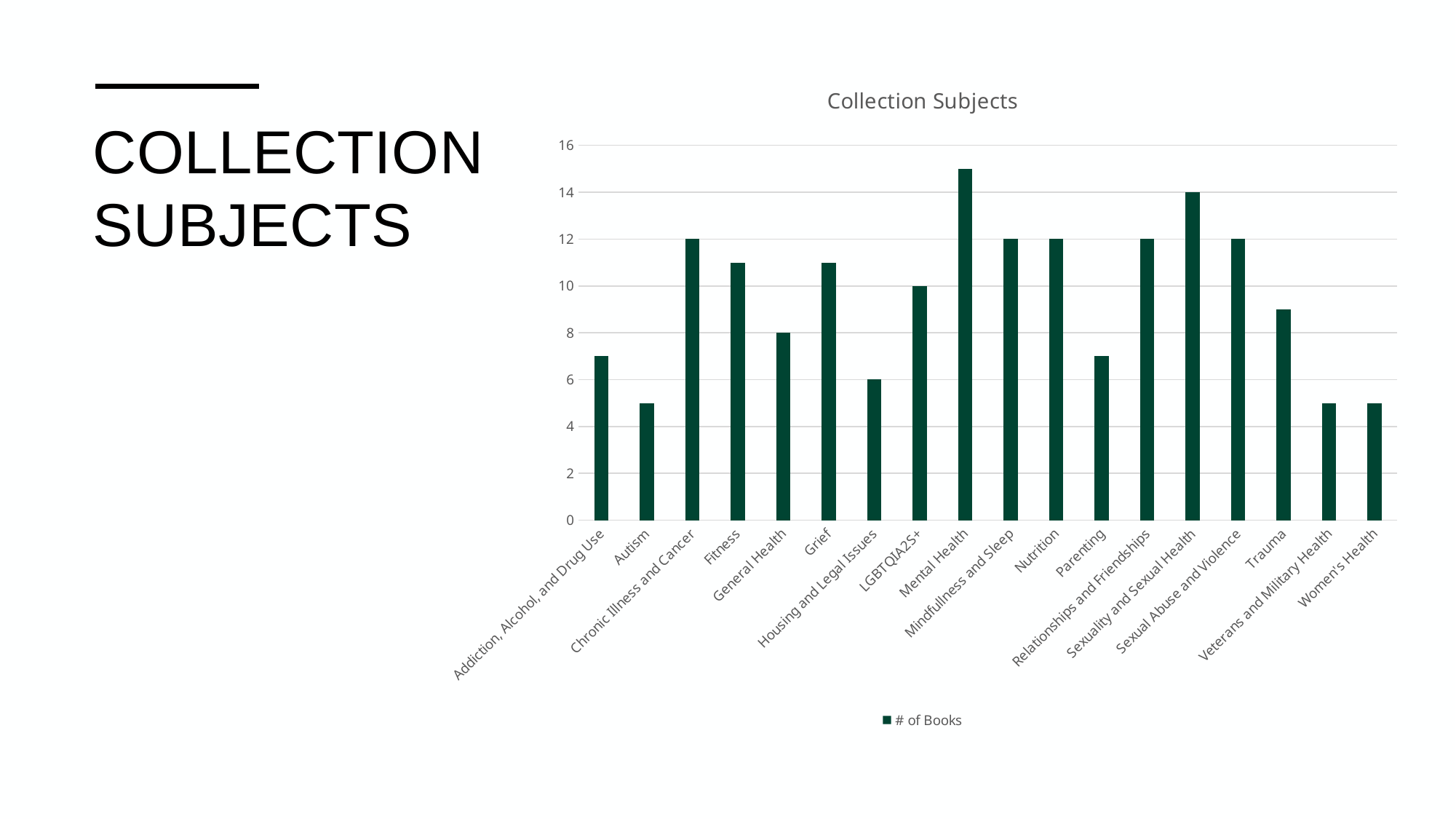
Which subject has the highest number of books? Mental Health Is the value for Trauma greater or less than 10? less How many subject categories are shown on the x axis? 18 What is the number of books for Sexuality and Sexual Health? 14 What is the difference in number of books between Sexuality and Sexual Health and Housing and Legal Issues? 8 How many series does the legend list? 1 What is the number of books for LGBTQIA2S+? 10 What type of chart is shown on the slide? bar chart What is the number of books for Housing and Legal Issues? 6 Which has more books, Chronic Illness and Cancer or General Health? Chronic Illness and Cancer What is the number of books for General Health? 8 What is the title of the chart? Collection Subjects